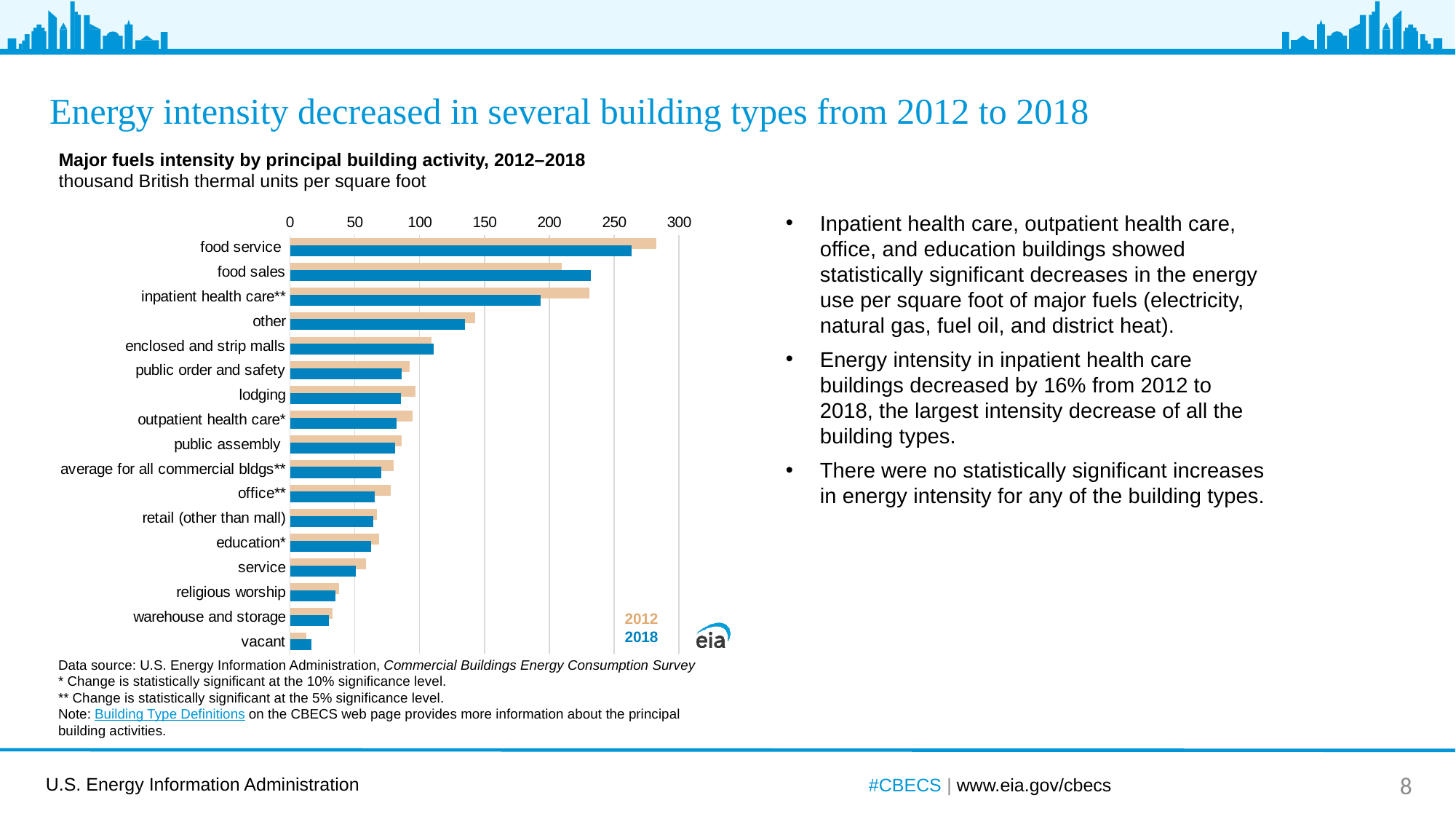
Is the 2018 value for food service greater or less than 250? greater Which building type has the lowest major fuels intensity in 2018? vacant How many series does the chart's legend list? 2 Is the 2012 value for food sales greater or less than 200? greater In 2018, which has the larger major fuels intensity: food sales or inpatient health care? food sales How many building activity categories are plotted on the chart? 17 For food service, which year has the larger major fuels intensity: 2012 or 2018? 2012 Is the 2018 value for vacant buildings greater or less than 50? less What unit of measurement is given for the chart's values? thousand British thermal units per square foot Which building type has the highest major fuels intensity in 2012? food service What kind of chart is shown on the slide? bar chart